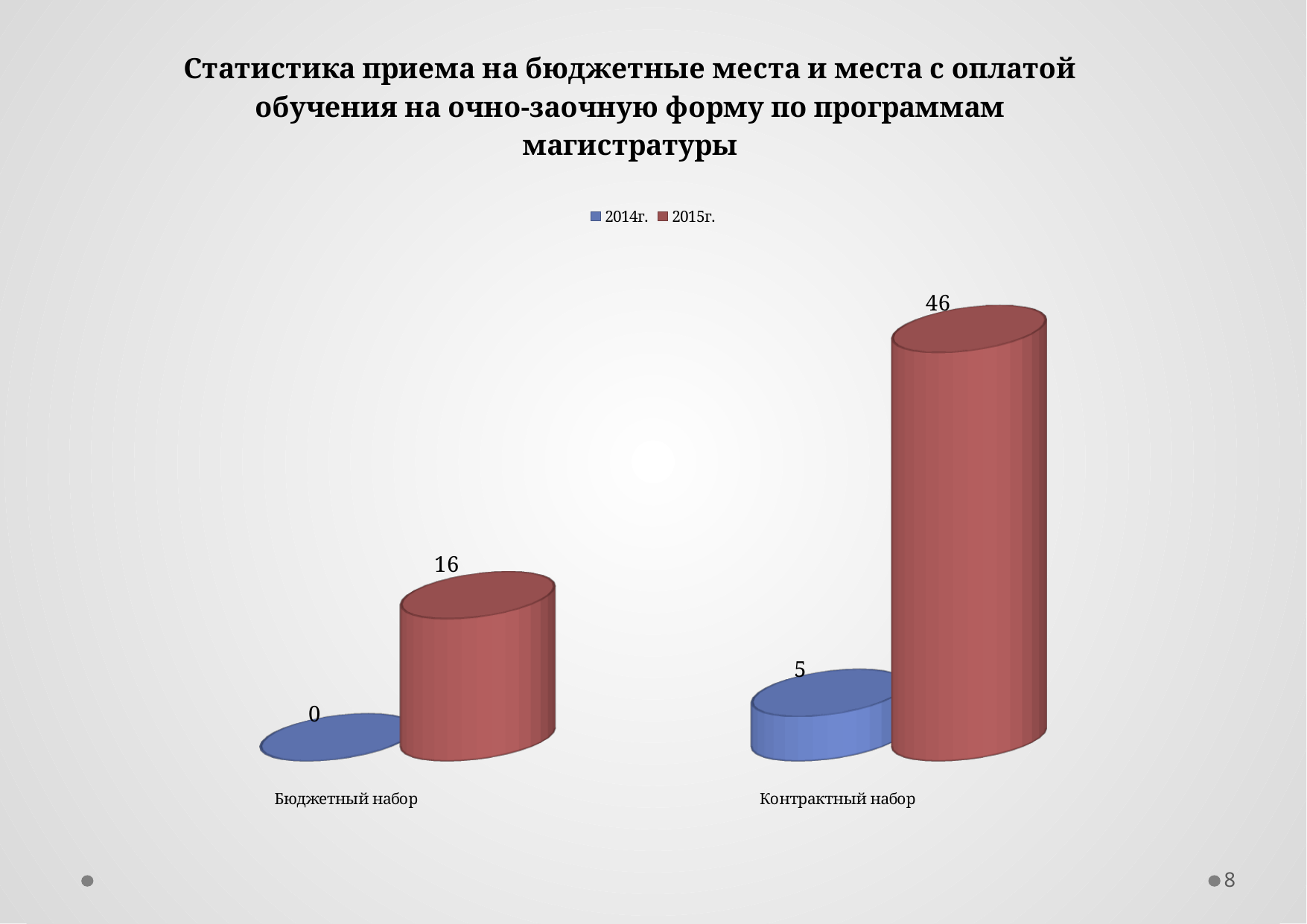
What is the value for 2014г. in the Контрактный набор category? 5 Which category has the lowest value for 2014г.? Бюджетный набор What is the difference between the 2015г. and 2014г. values for Контрактный набор? 41 How many categories are shown on the x axis? 2 Which is larger: the 2015г. value for Бюджетный набор or the 2014г. value for Контрактный набор? 2015г. value for Бюджетный набор What is the value for 2015г. in the Контрактный набор category? 46 What is the difference between the 2015г. values for Контрактный набор and Бюджетный набор? 30 Which category has the highest value for 2015г.? Контрактный набор What kind of chart is shown on the slide? Bar chart What is the value for 2015г. in the Бюджетный набор category? 16 How many series does the legend list? 2 What is the value for 2014г. in the Бюджетный набор category? 0